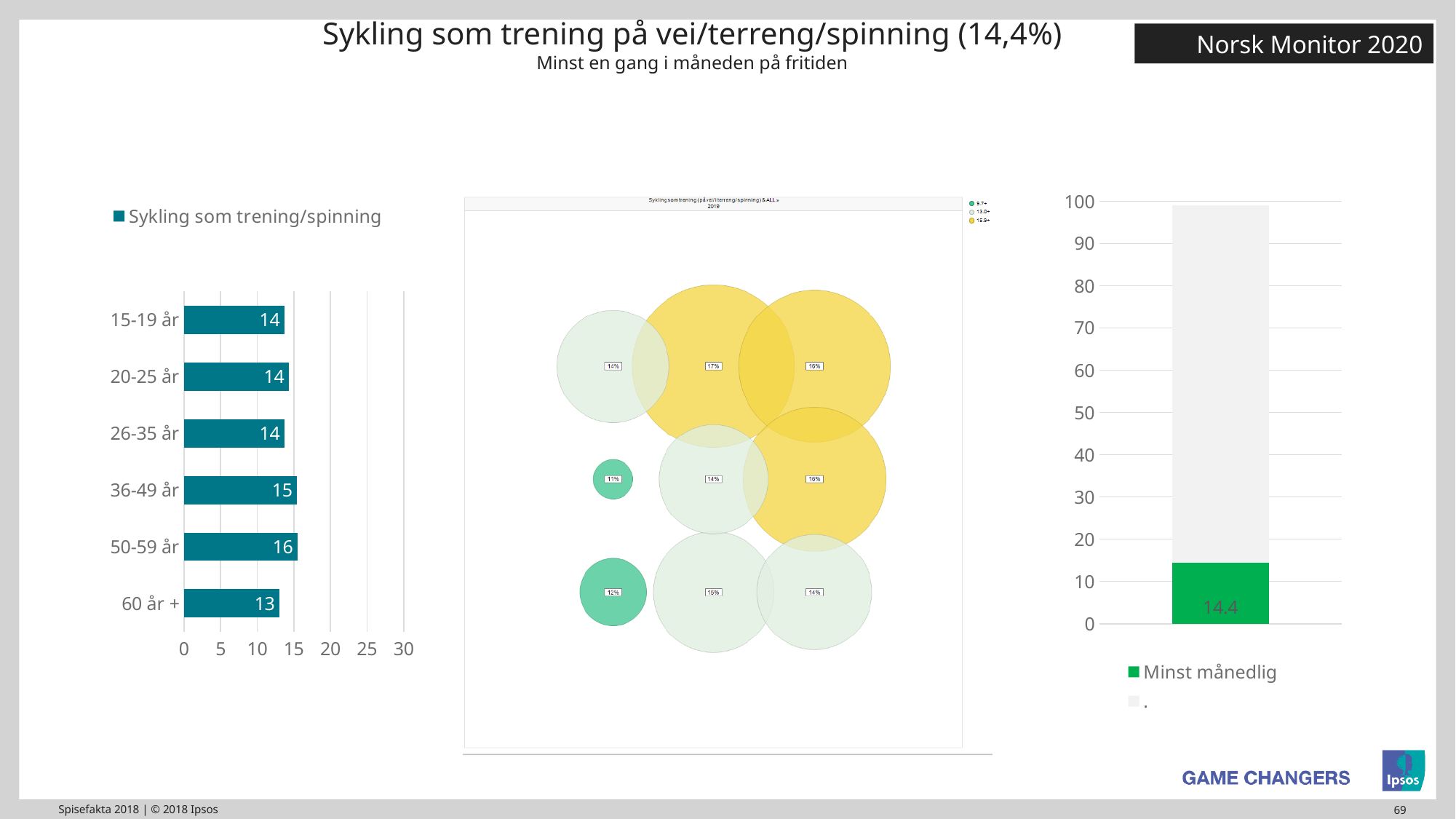
In the left bar chart, what is the value for 50-59 år? 16 What kind of chart is the chart on the left of the slide? bar chart In the left bar chart, what is the value for 60 år +? 13 How many age groups are shown in the left bar chart? 6 In the left bar chart, which age group has the highest value? 50-59 år In the right-hand chart, what is the value for Minst månedlig? 14,4 What is the main title of the slide? Sykling som trening på vei/terreng/spinning (14,4%) In the left bar chart, which is larger: the value for 36-49 år or for 26-35 år? 36-49 år In the left bar chart, which age group has the lowest value? 60 år + In the right-hand chart, is the value for Minst månedlig greater or less than 20? less In the left bar chart, what is the difference between the values for 50-59 år and 60 år +? 3 What is the legend entry of the left bar chart? Sykling som trening/spinning